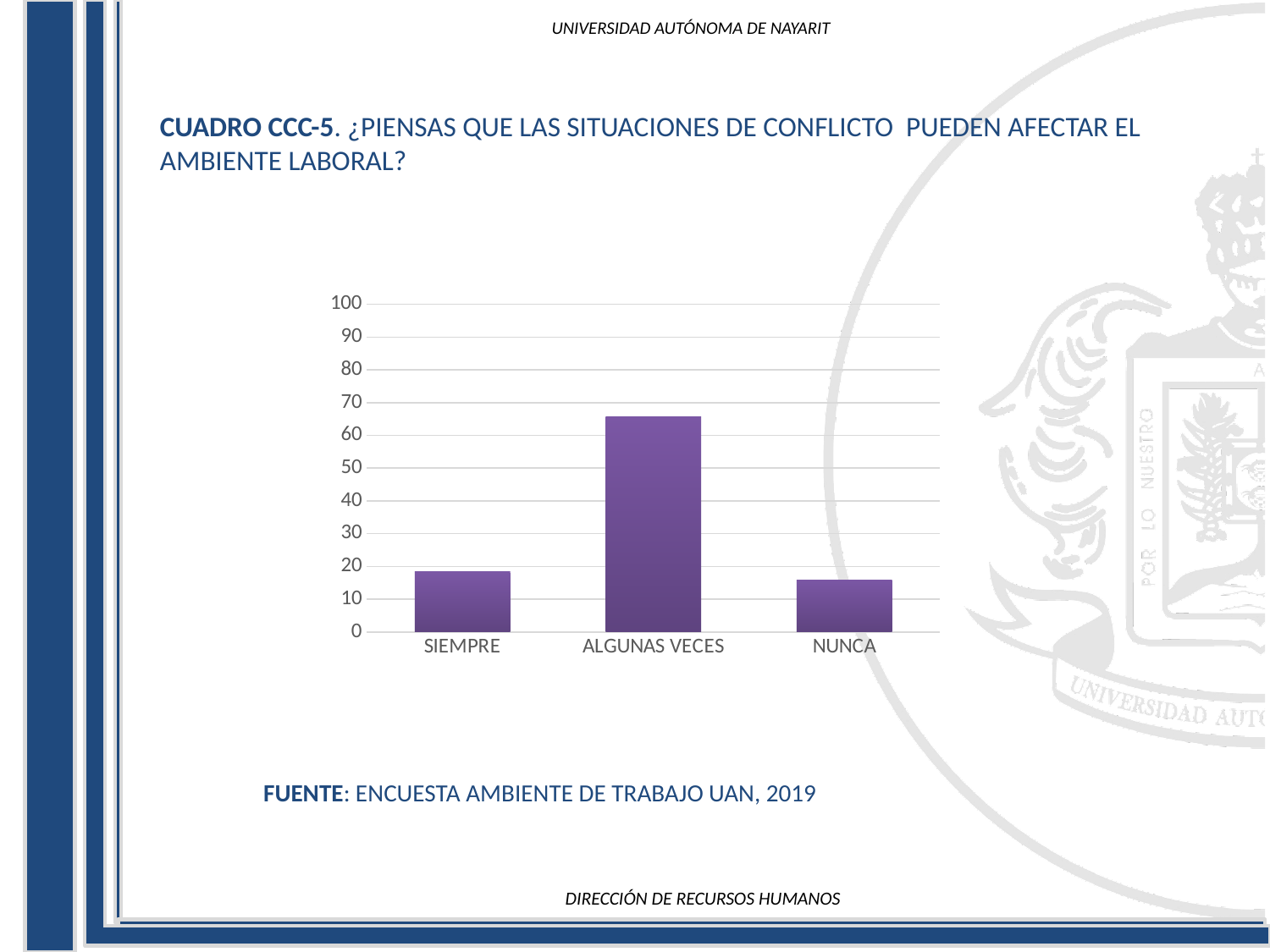
Is the value for ALGUNAS VECES greater or less than 70? less Is the value for ALGUNAS VECES greater or less than 60? greater What is the source cited below the chart? ENCUESTA AMBIENTE DE TRABAJO UAN, 2019 Which is larger, the value for SIEMPRE or the value for ALGUNAS VECES? ALGUNAS VECES Is the value for NUNCA greater or less than 10? greater How many categories are shown on the x axis of the chart? 3 Which category has the highest value in the chart? ALGUNAS VECES Which is larger, the value for ALGUNAS VECES or the value for NUNCA? ALGUNAS VECES What kind of chart is shown on the slide? bar chart